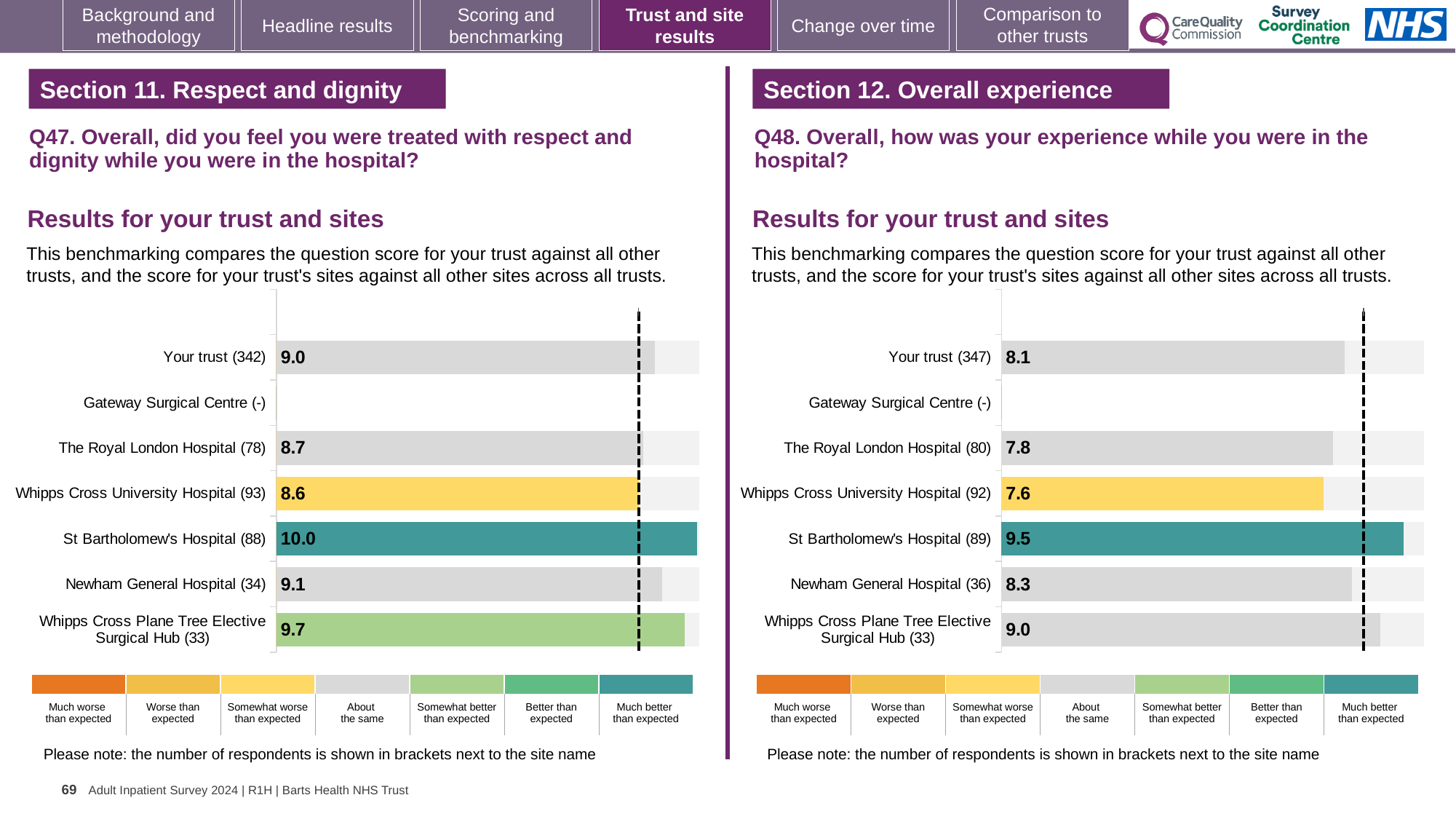
On the Q48 chart (right), which site has the lowest score shown? Whipps Cross University Hospital (92) What type of chart is used for the Q47 results (left)? Bar chart How many site/trust categories are listed on the Q48 chart (right)? 7 On the Q47 chart (left), what is the difference between the scores for St Bartholomew's Hospital (88) and Whipps Cross University Hospital (93)? 1.4 On the Q47 chart (left), what is the score for Your trust (342)? 9.0 On the Q48 chart (right), what is the score for Newham General Hospital (36)? 8.3 On the Q48 chart (right), what is the score for St Bartholomew's Hospital (89)? 9.5 On the Q47 chart (left), which site has the highest score? St Bartholomew's Hospital (88) On the Q47 chart (left), which site is shown with a yellow bar? Whipps Cross University Hospital (93) On the Q48 chart (right), what is the difference between the scores for Your trust (347) and The Royal London Hospital (80)? 0.3 On the Q48 chart (right), which has the higher score: Newham General Hospital (36) or The Royal London Hospital (80)? Newham General Hospital (36) On the Q47 chart (left), what is the score for Whipps Cross Plane Tree Elective Surgical Hub (33)? 9.7